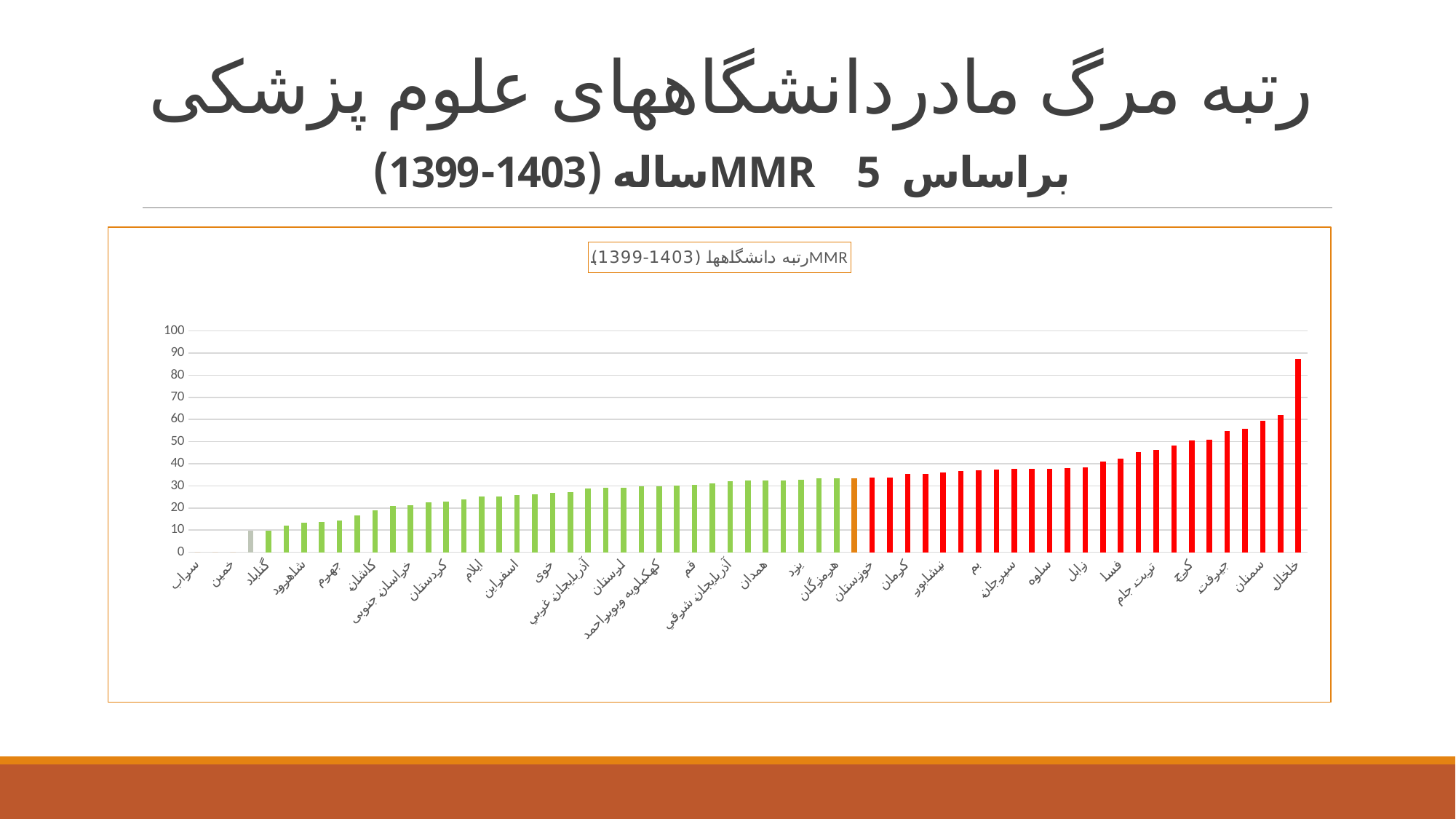
What kind of chart is shown on the slide? bar chart Is the value for گناباد greater or less than 20? less Is the value for ایلام greater or less than 30? less Which category has the highest value in the chart? خلخال Is the value for سمنان greater or less than 50? greater Do the values rise or fall from left to right along the x axis? rise What colour is the bar for خوزستان? red Which has the larger value, خلخال or گناباد? خلخال Which has the larger value, کاشان or کرمان? کرمان